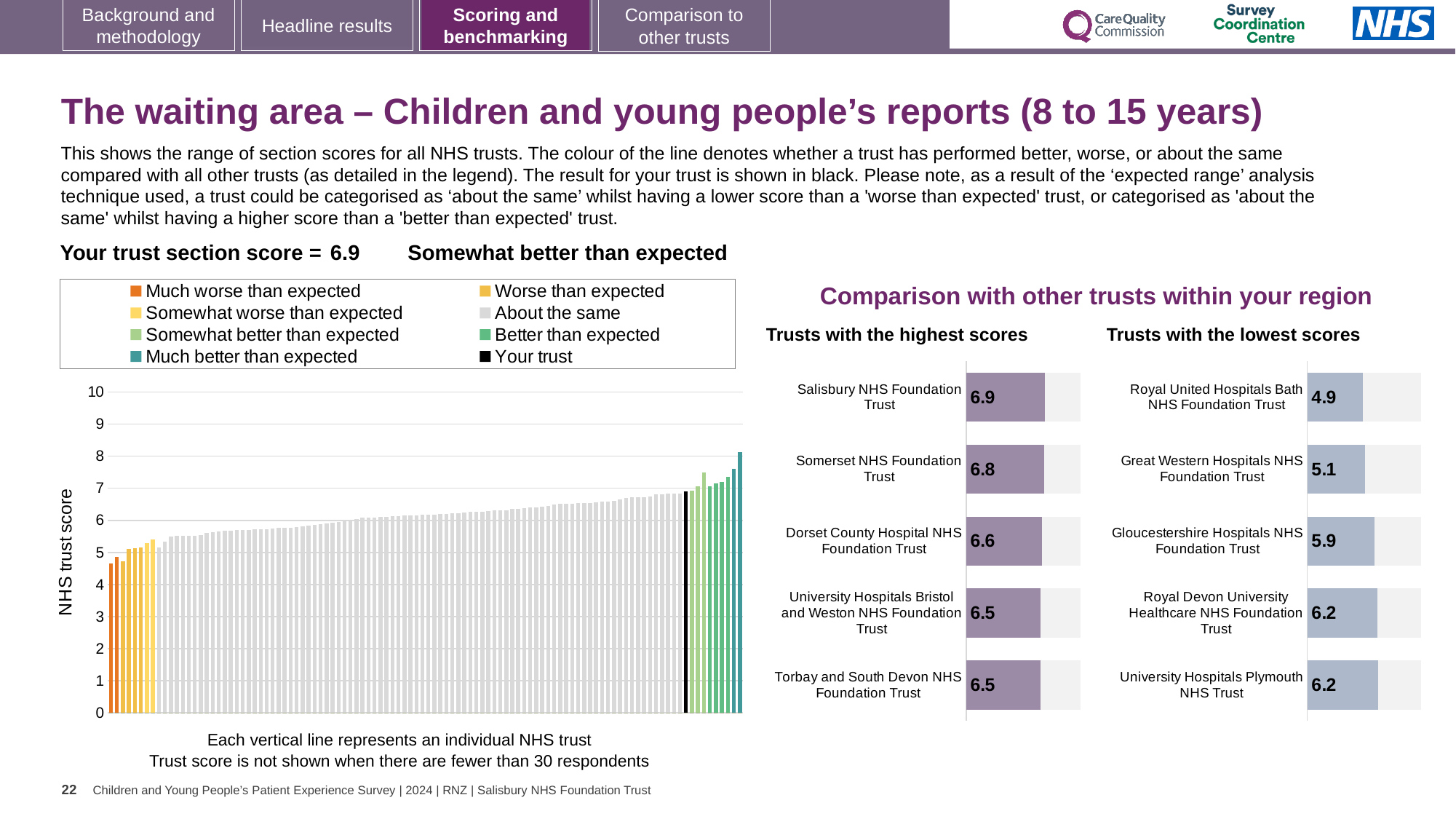
In the 'Trusts with the lowest scores' chart, what is the difference between Gloucestershire Hospitals NHS Foundation Trust and Great Western Hospitals NHS Foundation Trust? 0.8 In the 'Trusts with the highest scores' chart, what is the score for Salisbury NHS Foundation Trust? 6.9 What type of chart is the main chart on the left showing all NHS trusts? bar chart In the main chart on the left showing all NHS trusts, is the value for the black 'Your trust' bar greater or less than 6? greater In the 'Trusts with the highest scores' chart, which trust has the lowest score shown? University Hospitals Bristol and Weston NHS Foundation Trust and Torbay and South Devon NHS Foundation Trust (both 6.5) In the main chart on the left showing all NHS trusts, do the bar values rise or fall from left to right? rise In the 'Trusts with the highest scores' chart, what is the difference between Salisbury NHS Foundation Trust and Dorset County Hospital NHS Foundation Trust? 0.3 In the main chart on the left showing all NHS trusts, is the value for the leftmost bar greater or less than 5? less In the 'Trusts with the lowest scores' chart, which has the higher score: Great Western Hospitals NHS Foundation Trust or Gloucestershire Hospitals NHS Foundation Trust? Gloucestershire Hospitals NHS Foundation Trust How many trusts are listed in the 'Trusts with the highest scores' chart? 5 In the 'Trusts with the lowest scores' chart, which trust has the highest score shown? Royal Devon University Healthcare NHS Foundation Trust and University Hospitals Plymouth NHS Trust (both 6.2) In the 'Trusts with the lowest scores' chart, what is the score for Royal United Hospitals Bath NHS Foundation Trust? 4.9